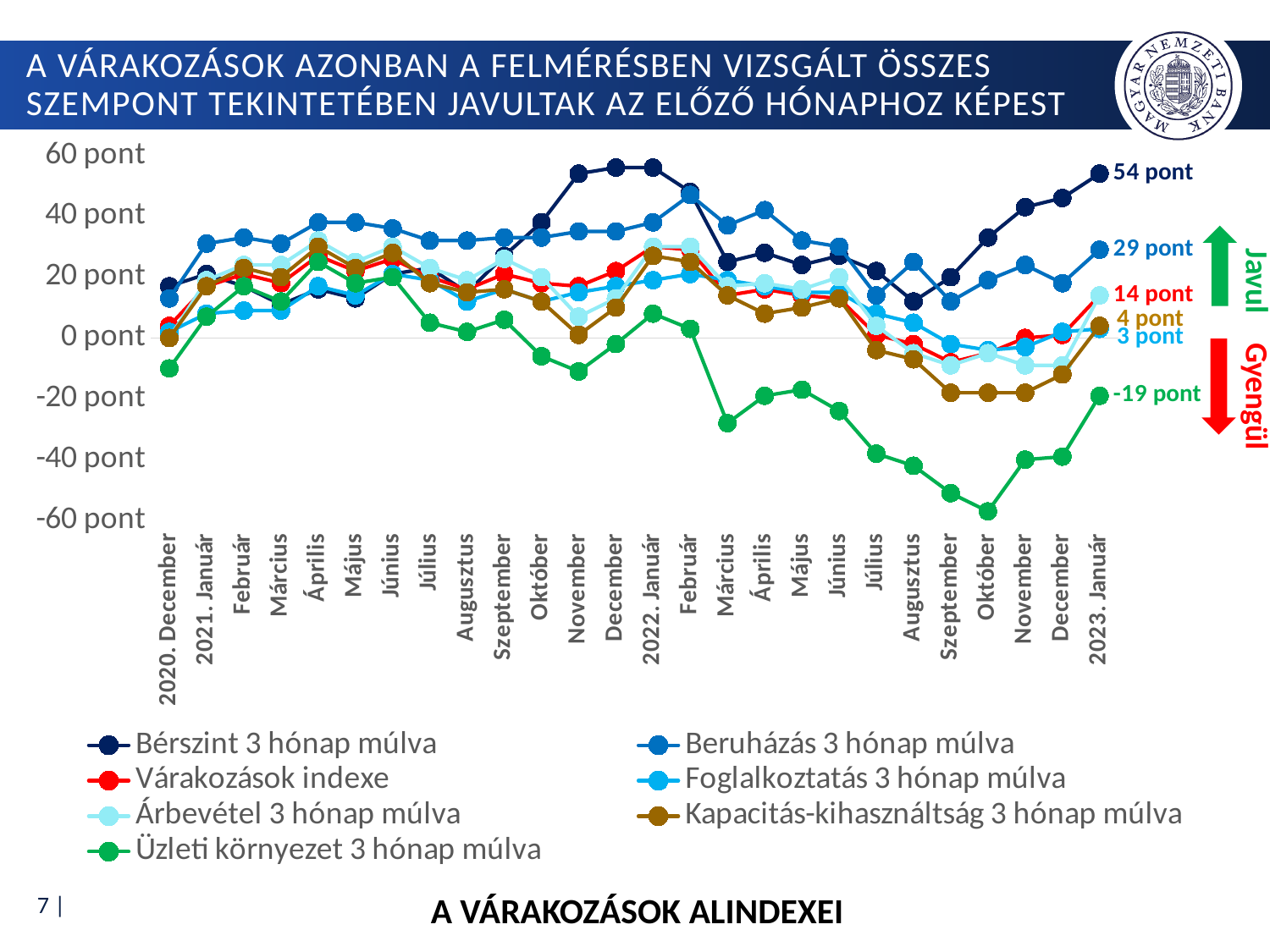
Which series has the lowest value in 2023. Január? Üzleti környezet 3 hónap múlva Which series has the highest value in 2023. Január? Bérszint 3 hónap múlva How many months are shown on the x axis? 26 What is the value of 'Várakozások indexe' in 2023. Január? 14 pont What is the value of 'Beruházás 3 hónap múlva' in 2023. Január? 29 pont Is the value of 'Üzleti környezet 3 hónap múlva' in Október 2022 greater or less than -40 pont? less What is the value of 'Bérszint 3 hónap múlva' in 2023. Január? 54 pont What kind of chart is shown on the slide? line chart What is the difference between 'Bérszint 3 hónap múlva' and 'Üzleti környezet 3 hónap múlva' in 2023. Január? 73 pont What is the value of 'Üzleti környezet 3 hónap múlva' in 2023. Január? -19 pont In 2023. Január, which is larger: 'Beruházás 3 hónap múlva' or 'Várakozások indexe'? Beruházás 3 hónap múlva How many series does the legend list? 7